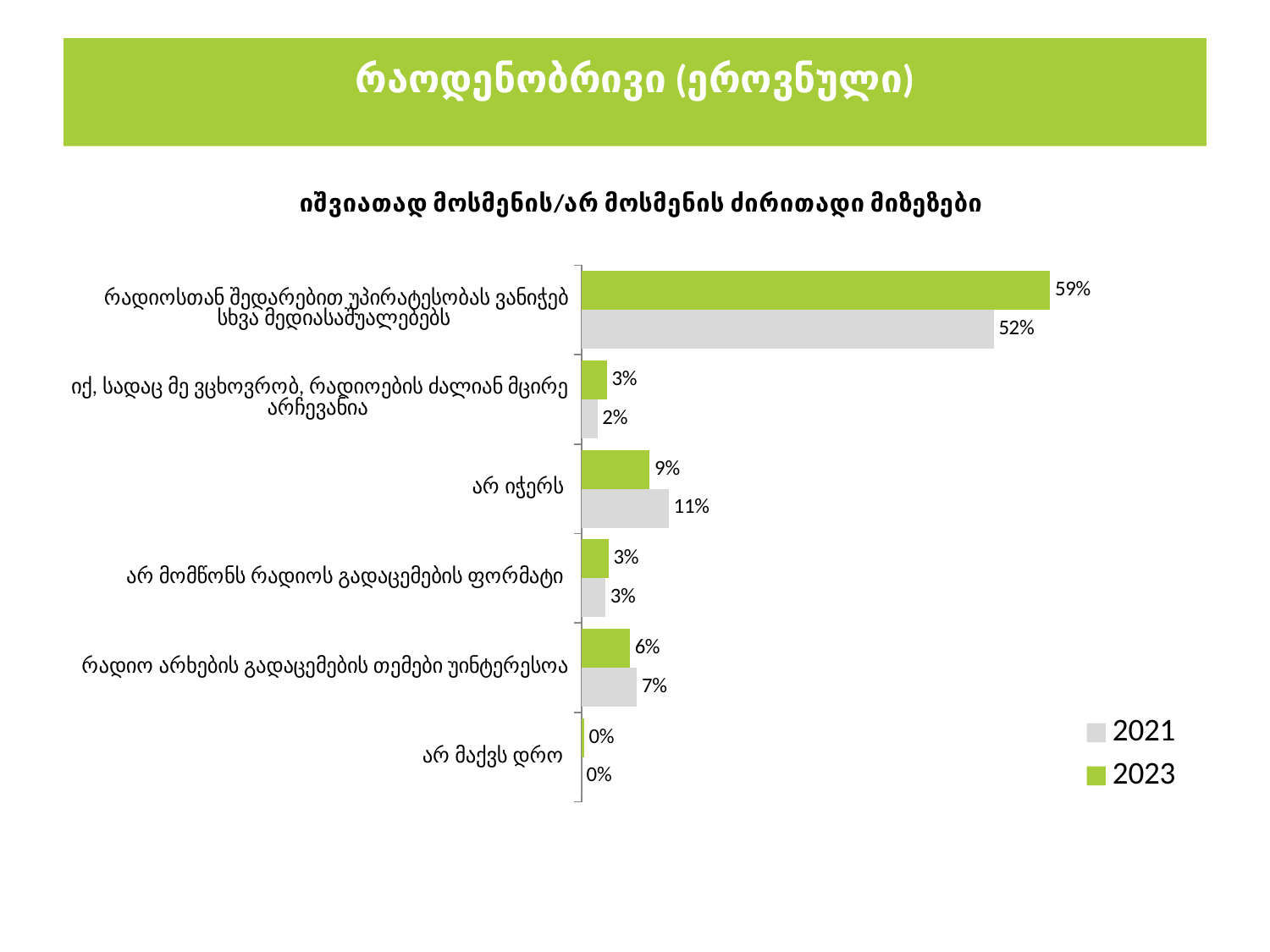
Which category has the lowest 2021 value? არ მაქვს დრო What is the 2021 value for "რადიო არხების გადაცემების თემები უინტერესოა"? 7% Which colour represents the 2023 series in the legend? Green What is the 2021 value for "რადიოსთან შედარებით უპირატესობას ვანიჭებ სხვა მედიასაშუალებებს"? 52% What is the 2023 value for "არ იჭერს"? 9% What is the title of the chart? იშვიათად მოსმენის/არ მოსმენის ძირითადი მიზეზები Which category has the highest 2023 value? რადიოსთან შედარებით უპირატესობას ვანიჭებ სხვა მედიასაშუალებებს What is the difference between the 2023 and 2021 values for "რადიოსთან შედარებით უპირატესობას ვანიჭებ სხვა მედიასაშუალებებს"? 7% What type of chart is shown on the slide? Bar chart For "არ იჭერს", which year has the larger value, 2021 or 2023? 2021 How many series does the legend list? 2 How many categories are shown in the chart? 6